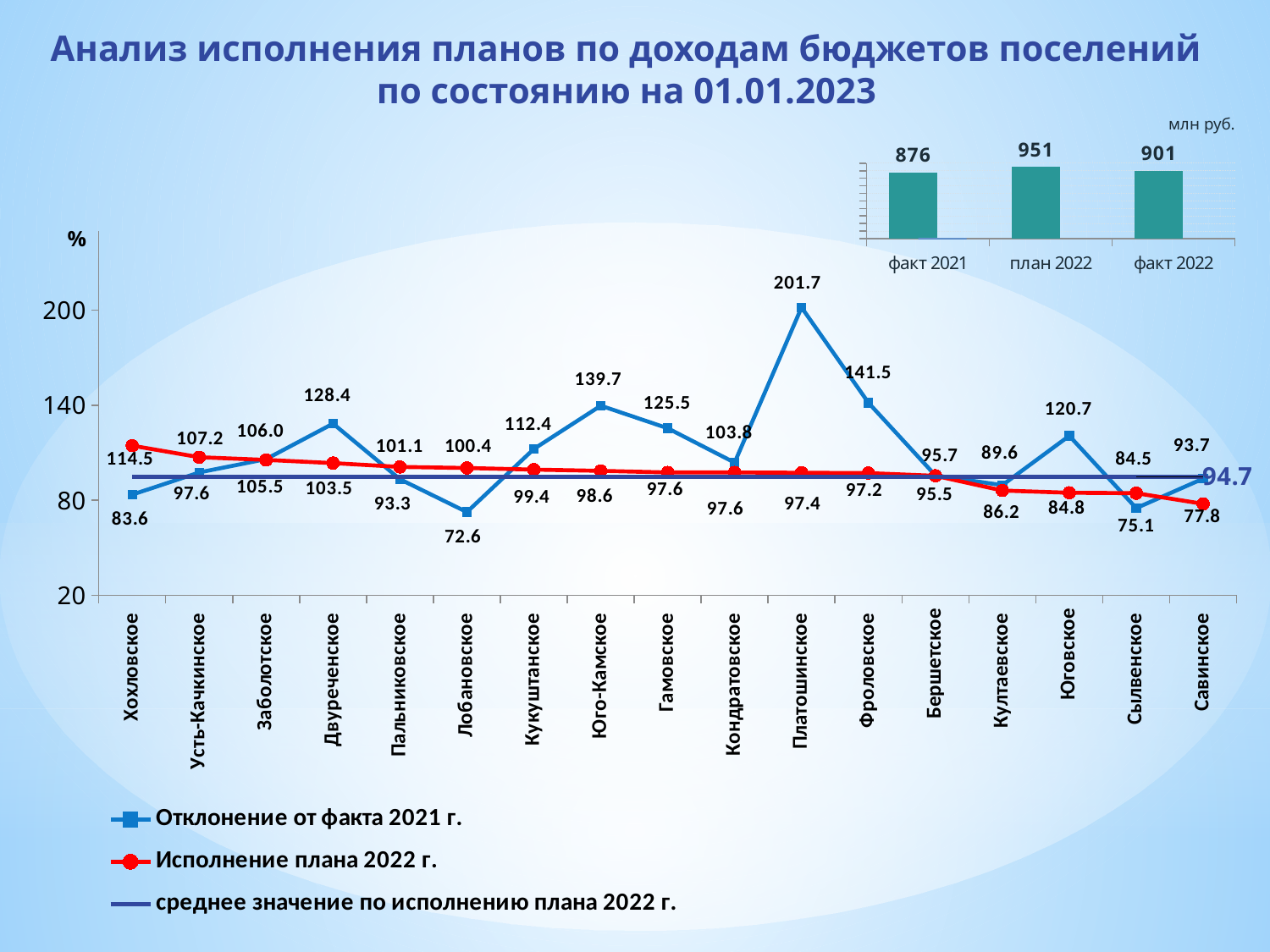
In the main line chart, which settlement has the lowest value of Отклонение от факта 2021 г.? Лобановское In the small bar chart at the top right, which category has the lowest value? факт 2021 In the small bar chart at the top right, how many bars are shown? 3 In the main line chart, how many series does the legend list? 3 In the small bar chart at the top right, what is the difference between план 2022 and факт 2022? 50 In the main line chart, what is the difference between Отклонение от факта 2021 г. and Исполнение плана 2022 г. for Лобановское? 27.8 In the main line chart, what is the value of Отклонение от факта 2021 г. for Платошинское? 201.7 In the main line chart, how many settlements are shown on the x axis? 17 In the main line chart, which settlement has the lowest value of Исполнение плана 2022 г.? Савинское In the main line chart, what is the value of Исполнение плана 2022 г. for Хохловское? 114.5 In the small bar chart at the top right, what is the value for план 2022? 951 In the main line chart, which settlement has the highest value of Отклонение от факта 2021 г.? Платошинское